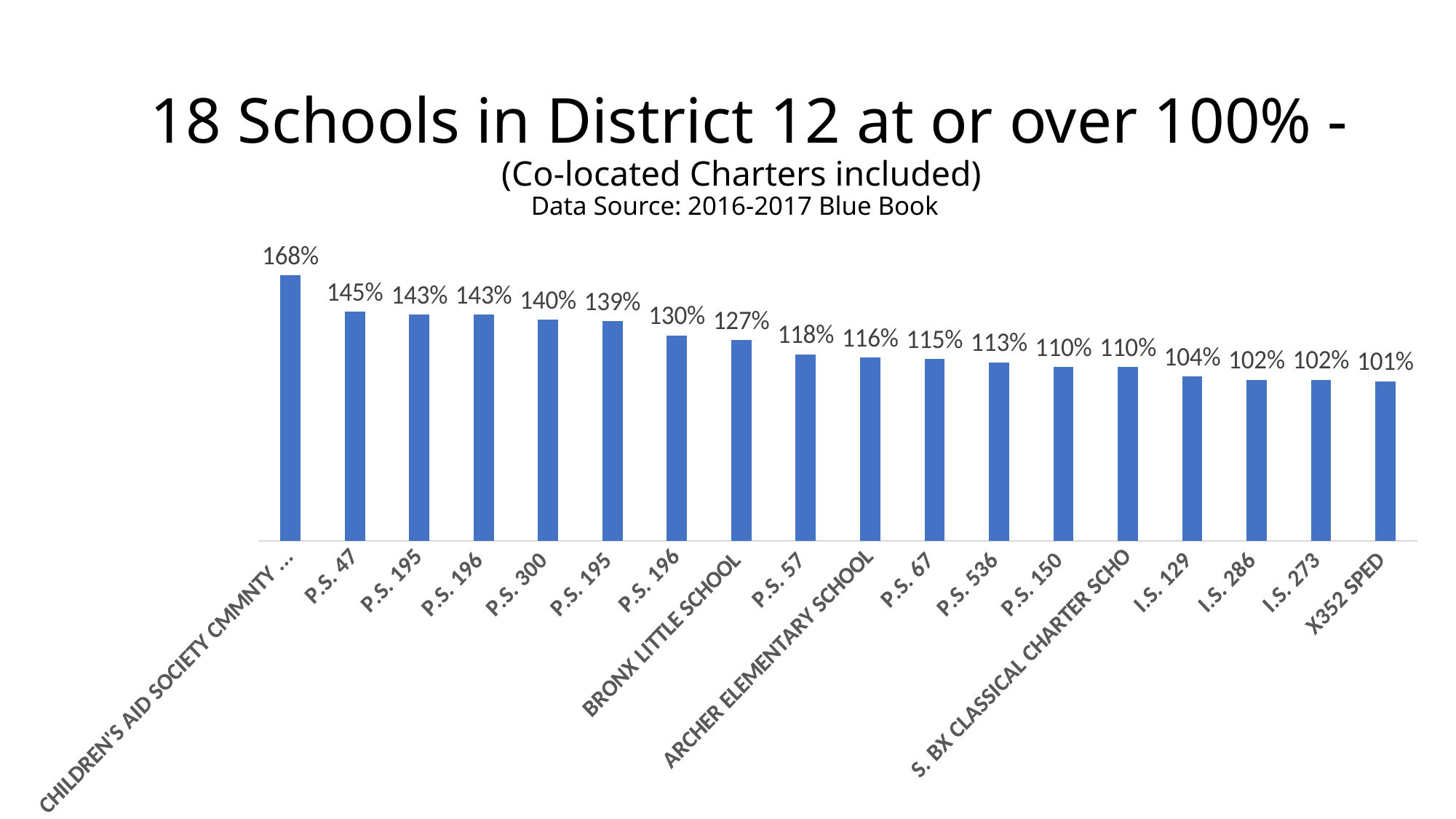
How many schools (bars) are plotted in the chart? 18 What is the highest value shown in the chart? 168% Which school has the lowest value in the chart? X352 SPED What is the value shown for I.S. 129? 104% What is the difference between the values for P.S. 47 and P.S. 300? 5% What is the value shown for P.S. 47? 145% What kind of chart is shown on the slide? bar chart What is the value shown for BRONX LITTLE SCHOOL? 127% What is the value shown for ARCHER ELEMENTARY SCHOOL? 116% What is the value shown for P.S. 300? 140% Which has the larger value, P.S. 57 or P.S. 67? P.S. 57 Do the values rise or fall moving from left to right along the x axis? fall